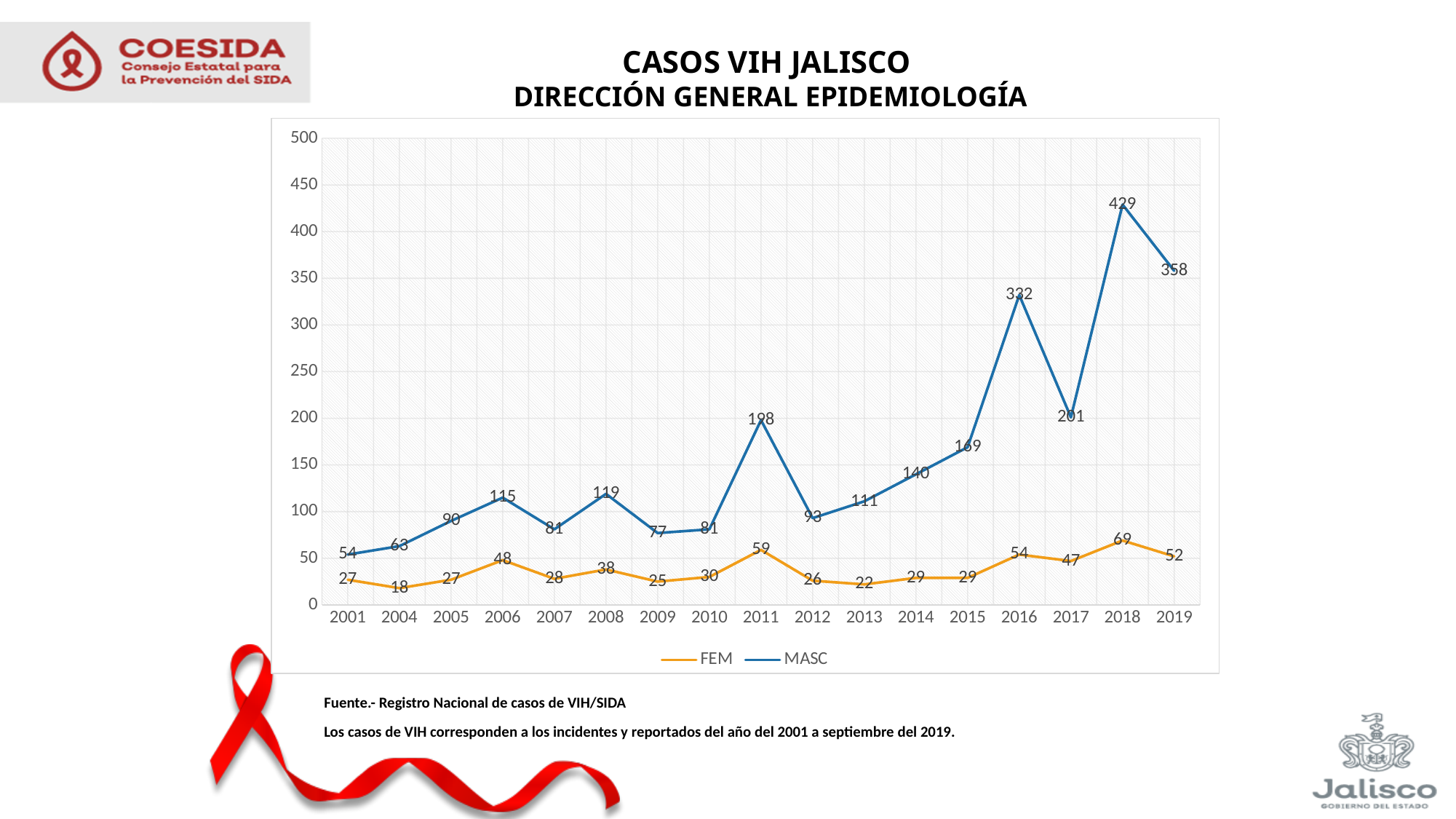
What is the difference between the MASC and FEM values in 2019? 306 What is the MASC value for 2018? 429 In which year does the MASC series reach its highest value? 2018 What are the two series named in the legend? FEM and MASC Which is larger, the MASC value for 2011 or the MASC value for 2017? 2017 What is the FEM value for 2011? 59 How many series does the legend list? 2 How many years are shown on the x axis? 17 Does the MASC series rise or fall from 2018 to 2019? Fall What kind of chart is shown on the slide? Line chart In which year does the FEM series have its lowest value? 2004 What is the MASC value for 2016? 332